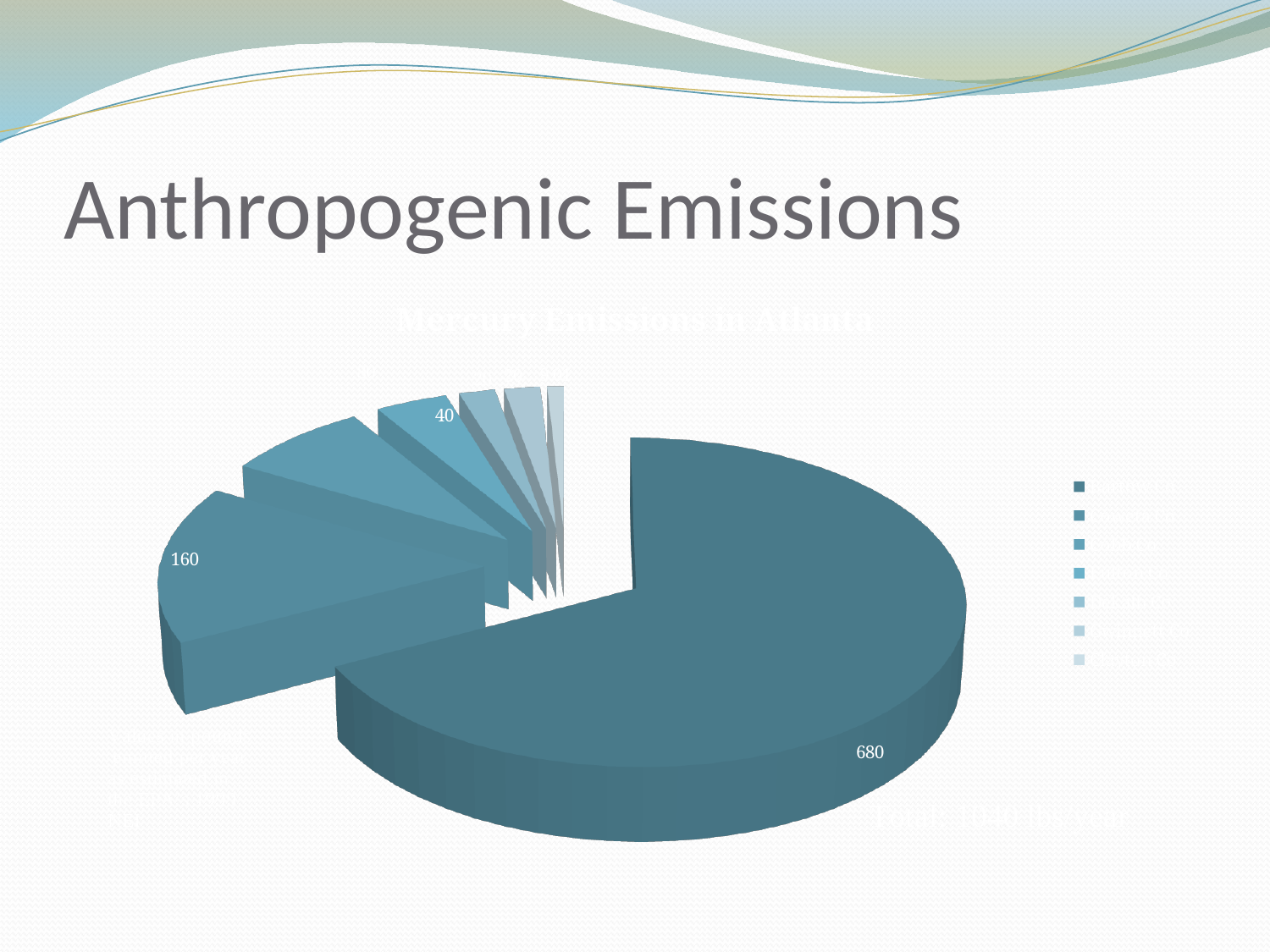
What kind of chart is shown on the slide? pie chart How many entries does the legend of the pie chart list? 7 What is the difference between the slice labelled 160 and the slice labelled 40? 120 What is the difference between the slice labelled 680 and the slice labelled 40? 640 What is the title of the pie chart? Mercury Emissions in Atlanta What value is labelled on the second-largest slice of the pie chart? 160 Which is larger, the slice labelled 680 or the slice labelled 160? 680 What value is labelled on the largest slice of the pie chart? 680 What is the difference between the slice labelled 680 and the slice labelled 160? 520